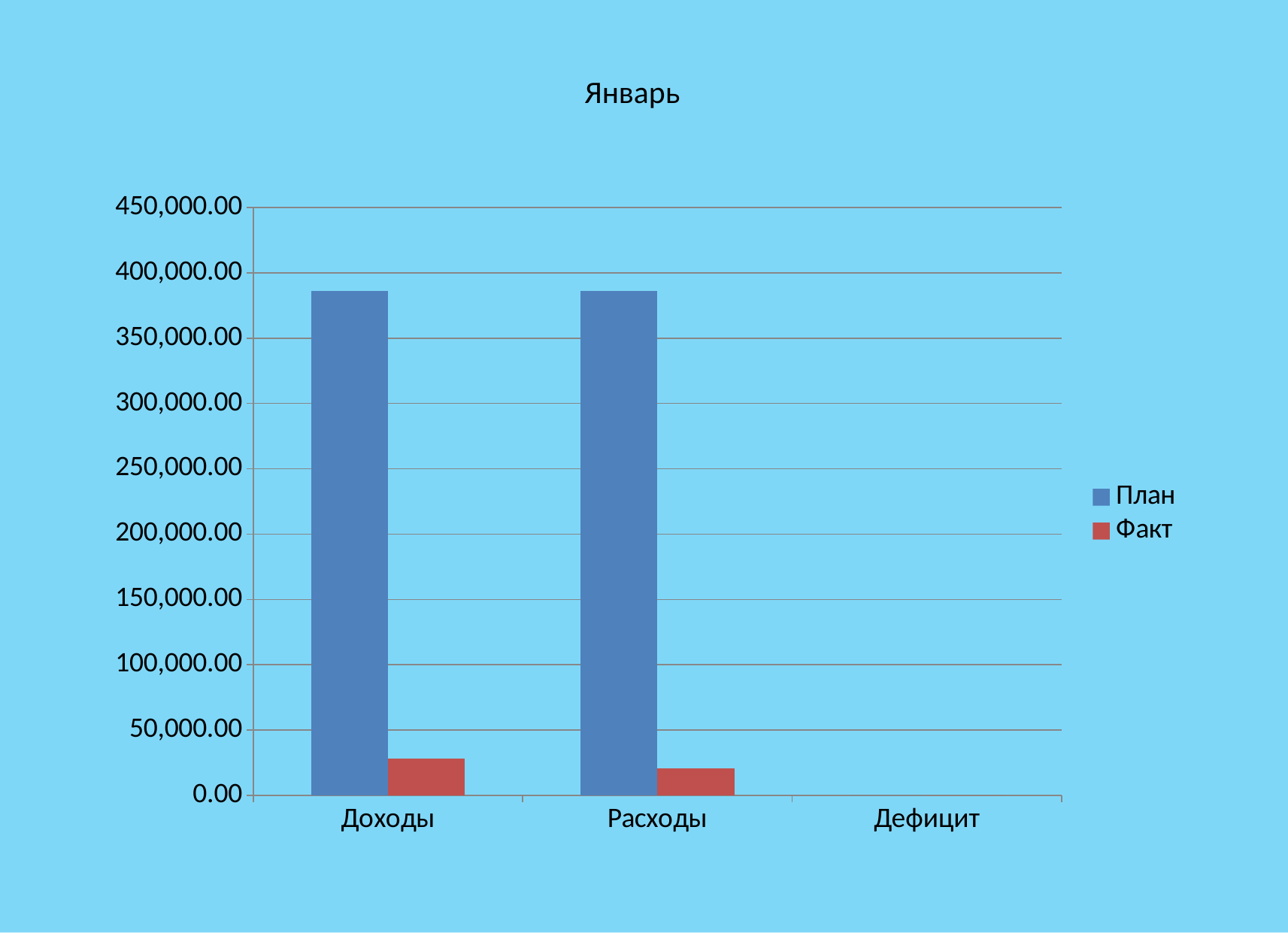
Which category has the highest Факт value? Доходы What is the title of the chart? Январь Is the Факт value for Расходы greater or less than 50,000.00? less For Доходы, which is larger: План or Факт? План Is the План value for Доходы greater or less than 350,000.00? greater Is the Факт value for Доходы greater or less than 50,000.00? less What kind of chart is shown on the slide? bar chart How many series does the legend list? 2 Which category has the lowest План value? Дефицит Which series is shown in red? Факт How many categories are shown on the x axis? 3